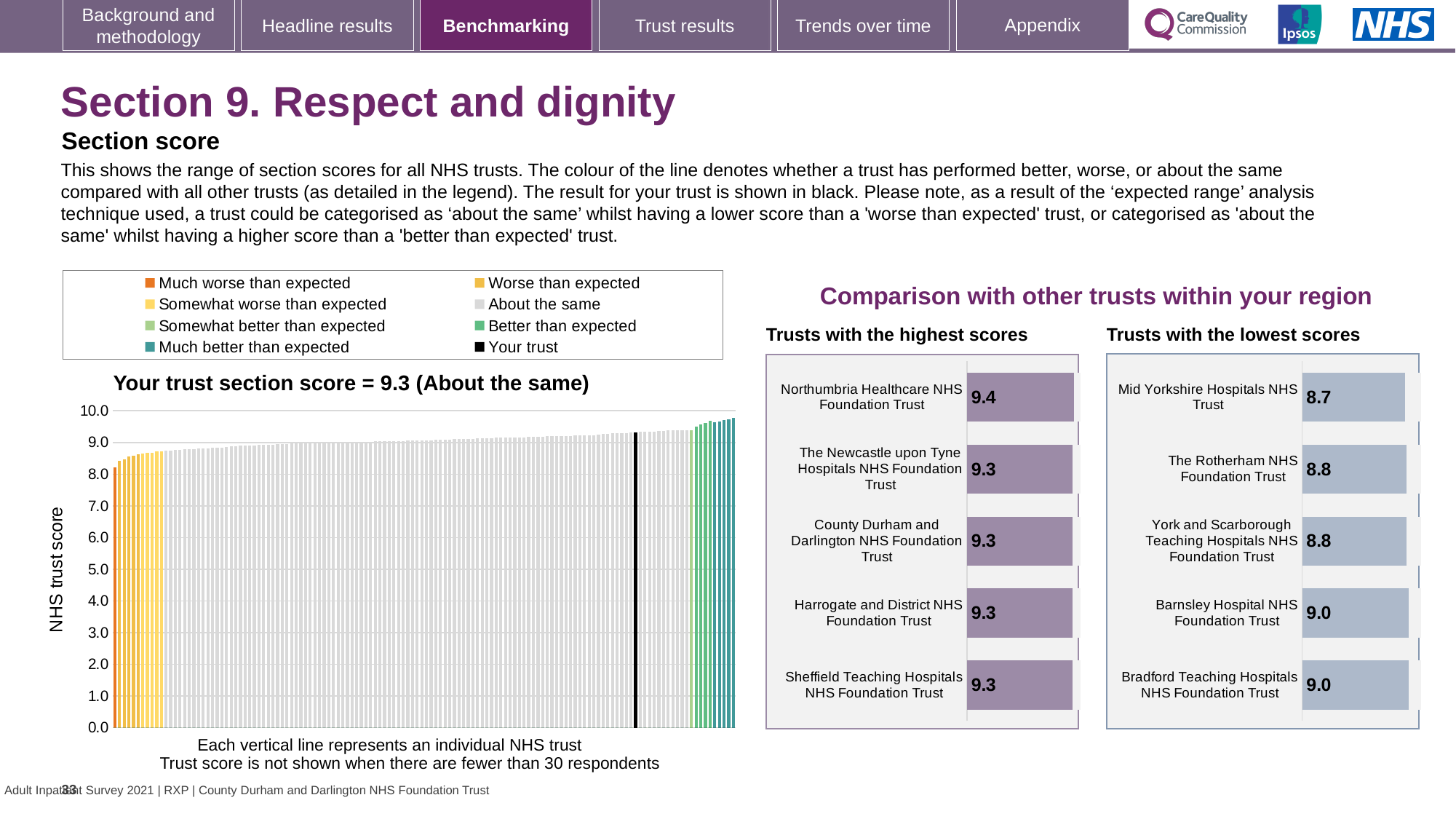
What is the y-axis label on the 'Your trust section score' chart? NHS trust score On the 'Your trust section score' chart, do the bar values rise or fall from left to right along the x axis? rise On the 'Trusts with the lowest scores' chart, which has the larger score: Barnsley Hospital NHS Foundation Trust or The Rotherham NHS Foundation Trust? Barnsley Hospital NHS Foundation Trust On the 'Your trust section score' chart, what is the section score for your trust? 9.3 On the 'Trusts with the highest scores' chart, how many trusts are shown? 5 On the 'Trusts with the highest scores' chart, which trust has the highest score? Northumbria Healthcare NHS Foundation Trust What kind of chart is the 'Your trust section score' chart on the left of the slide? bar chart How many entries does the legend above the 'Your trust section score' chart list? 8 On the 'Trusts with the lowest scores' chart, which trust has the lowest score? Mid Yorkshire Hospitals NHS Trust On the 'Your trust section score' chart, is the value of the tallest bar greater or less than 10.0? less On the 'Trusts with the highest scores' chart, what is the score for Northumbria Healthcare NHS Foundation Trust? 9.4 On the 'Trusts with the highest scores' chart, what is the difference between the scores of Northumbria Healthcare NHS Foundation Trust and Sheffield Teaching Hospitals NHS Foundation Trust? 0.1